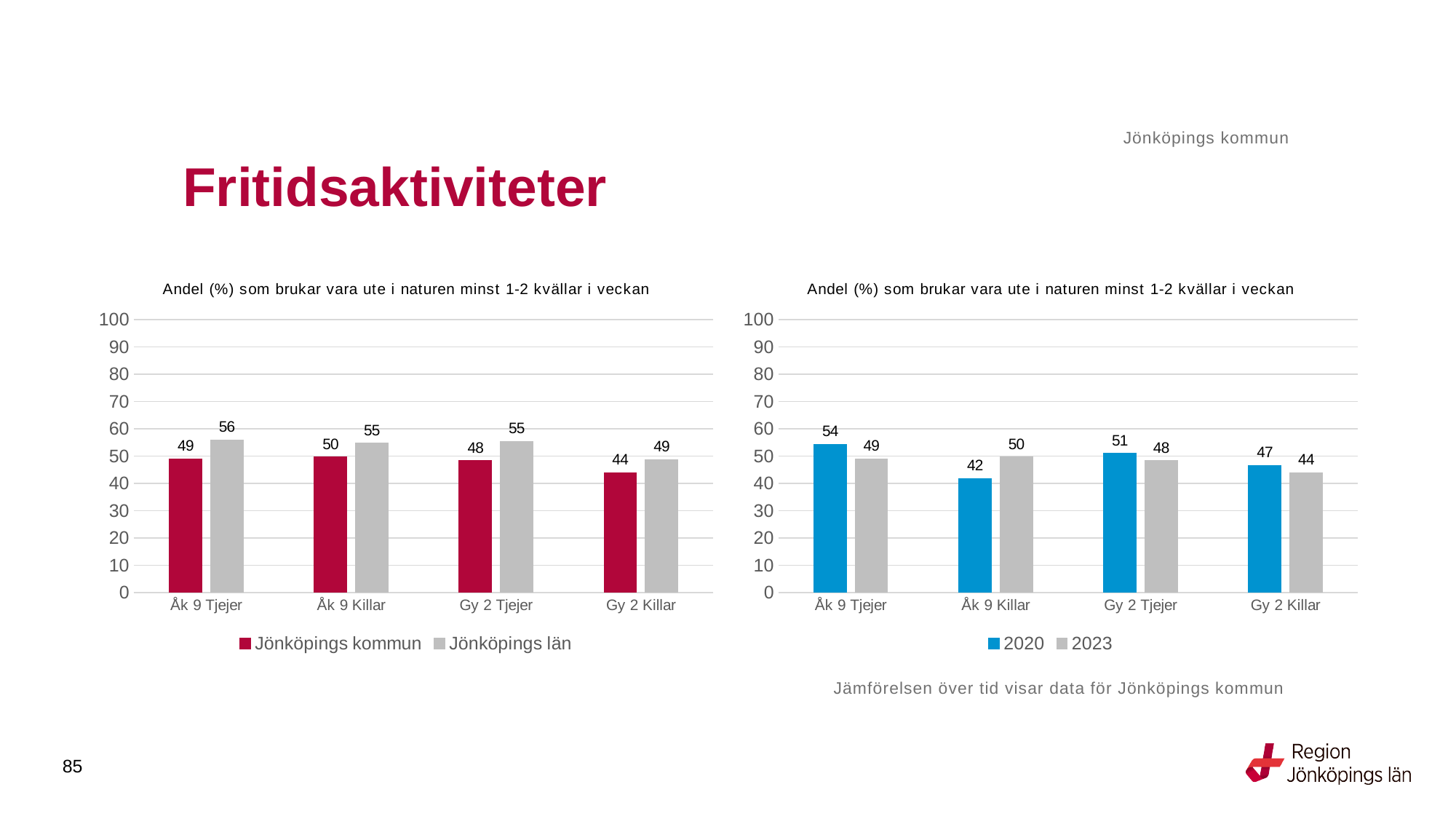
How many series does the legend of the right chart list? 2 In the left chart, what is the value for Jönköpings kommun for Åk 9 Tjejer? 49 In the right chart, what is the value for 2020 for Åk 9 Killar? 42 In the right chart, what is the value for 2023 for Gy 2 Tjejer? 48 In the left chart, what is the value for Jönköpings län for Gy 2 Killar? 49 In the right chart, what is the difference between 2020 and 2023 for Åk 9 Killar? 8 In the left chart, which category has the lowest value for Jönköpings kommun? Gy 2 Killar What kind of chart is the left chart? Bar chart How many categories are shown on the x axis of the left chart? 4 In the left chart, what is the difference between Jönköpings län and Jönköpings kommun for Åk 9 Tjejer? 7 In the right chart, which is larger for Gy 2 Killar: 2020 or 2023? 2020 In the right chart, which category has the highest value for 2020? Åk 9 Tjejer